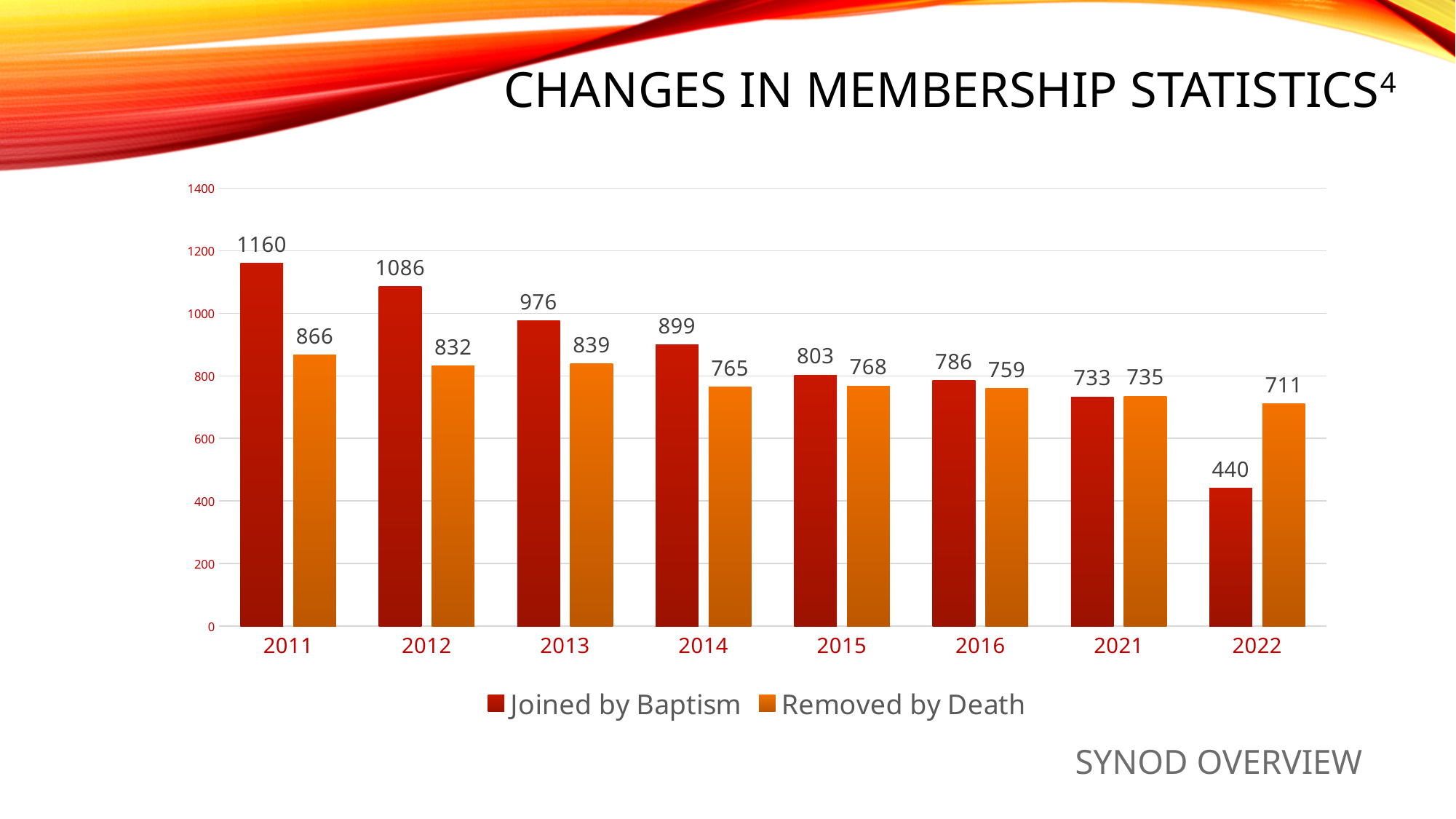
What is the value for Joined by Baptism in 2011? 1160 Which year has the highest value for Removed by Death? 2011 In 2013, which is larger: Joined by Baptism or Removed by Death? Joined by Baptism What is the value for Removed by Death in 2014? 765 What is the value for Removed by Death in 2022? 711 How many years are shown on the x axis? 8 What kind of chart is shown on the slide? Bar chart Which year has the lowest value for Joined by Baptism? 2022 How many series does the legend list? 2 What is the difference between Joined by Baptism and Removed by Death in 2012? 254 What is the difference between Removed by Death and Joined by Baptism in 2022? 271 Do the Joined by Baptism values rise or fall from 2011 to 2022? Fall